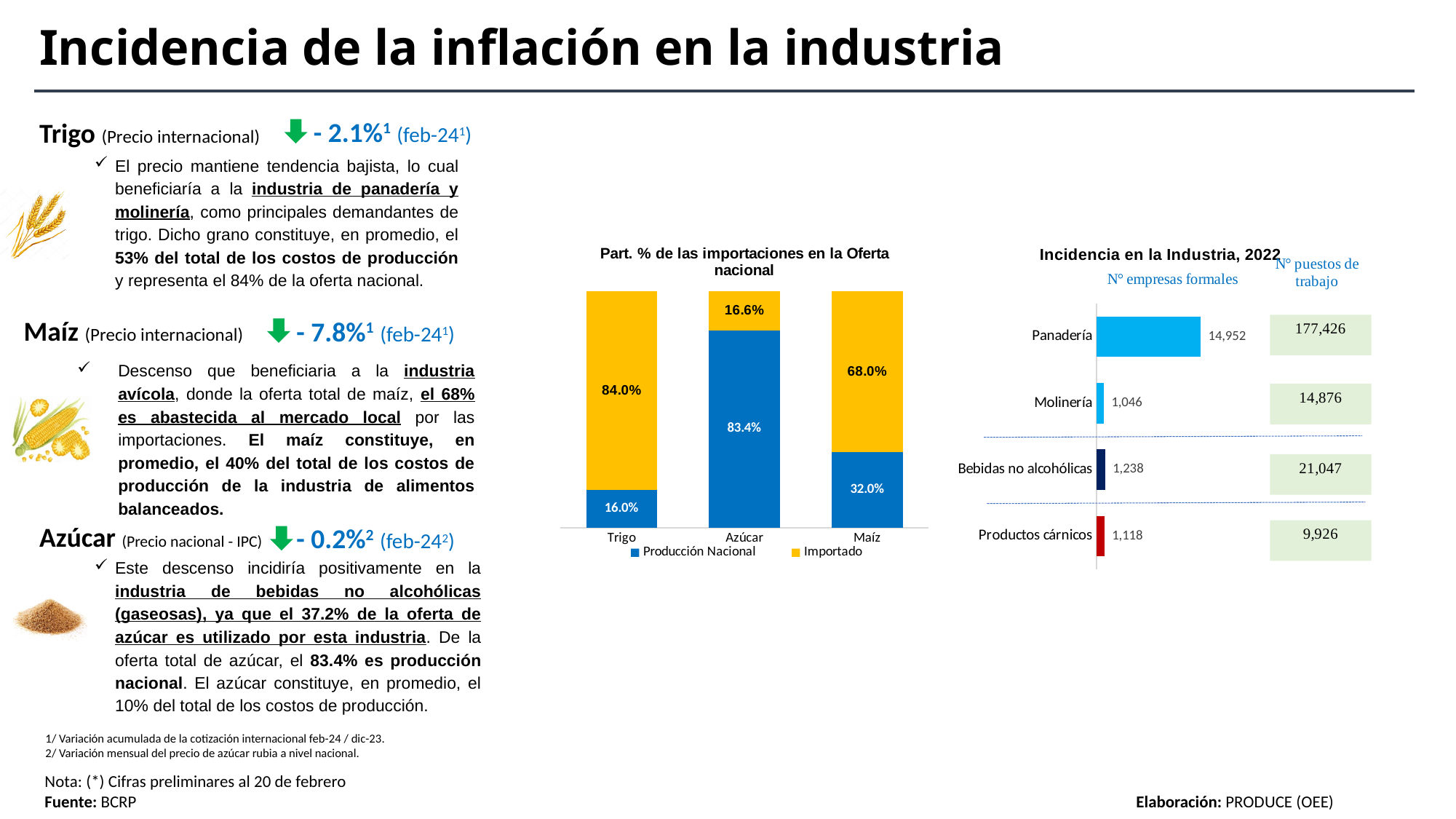
What kind of chart is 'Part. % de las importaciones en la Oferta nacional'? Stacked bar chart In the chart 'Incidencia en la Industria, 2022', which category has the lowest N° empresas formales? Molinería In the chart 'Part. % de las importaciones en la Oferta nacional', what is the Producción Nacional share for Azúcar? 83.4% In the chart 'Part. % de las importaciones en la Oferta nacional', what is the difference between the Importado share for Trigo and the Importado share for Maíz? 16.0% In the chart 'Part. % de las importaciones en la Oferta nacional', what is the Importado share for Trigo? 84.0% In the chart 'Part. % de las importaciones en la Oferta nacional', how many series does the legend list? 2 In the chart 'Incidencia en la Industria, 2022', how many categories are shown? 4 In the chart 'Incidencia en la Industria, 2022', what is the difference in N° empresas formales between Bebidas no alcohólicas and Productos cárnicos? 120 In the chart 'Incidencia en la Industria, 2022', what is the N° empresas formales for Panadería? 14,952 In the chart 'Part. % de las importaciones en la Oferta nacional', which category has the highest Producción Nacional share? Azúcar In the chart 'Part. % de las importaciones en la Oferta nacional', what is the Importado share for Maíz? 68.0% In the chart 'Part. % de las importaciones en la Oferta nacional', which category has the lowest Importado share? Azúcar